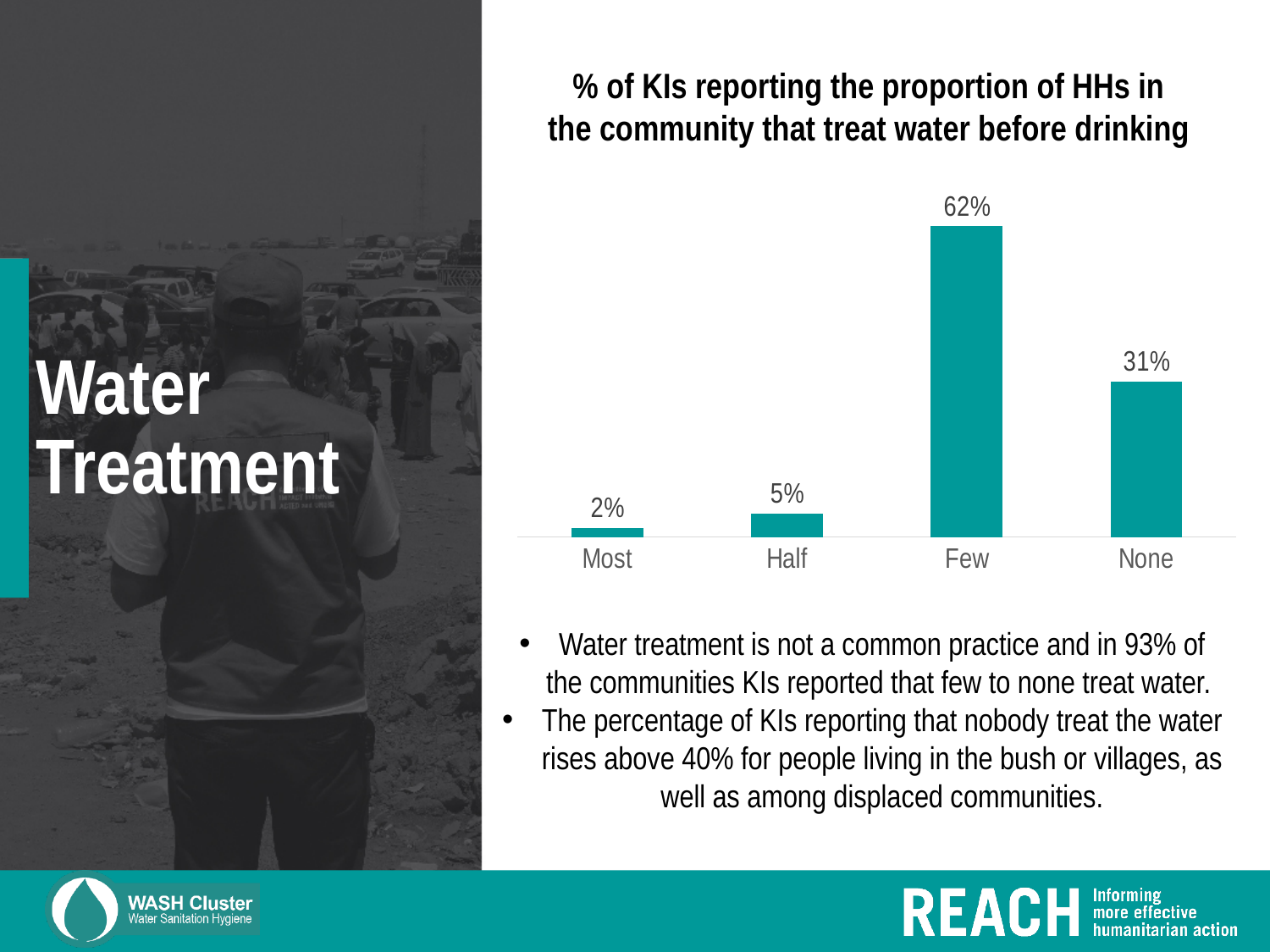
What percentage of KIs reported that none of the households treat water before drinking? 31% Which category has a larger value, 'Half' or 'None'? None What is the title of the chart? % of KIs reporting the proportion of HHs in the community that treat water before drinking Which category has the lowest percentage of KIs reporting it? Most What type of chart is shown on the slide? Bar chart What is the difference in percentage points between the 'Few' and 'None' categories? 31% What percentage of KIs reported that few households in the community treat water before drinking? 62% What is the difference in percentage points between the 'Half' and 'Most' categories? 3% How many categories are shown on the x axis of the chart? 4 What percentage of KIs reported that most households treat water before drinking? 2% What percentage of KIs reported that half of the households treat water before drinking? 5% Which category has the highest percentage of KIs reporting it? Few